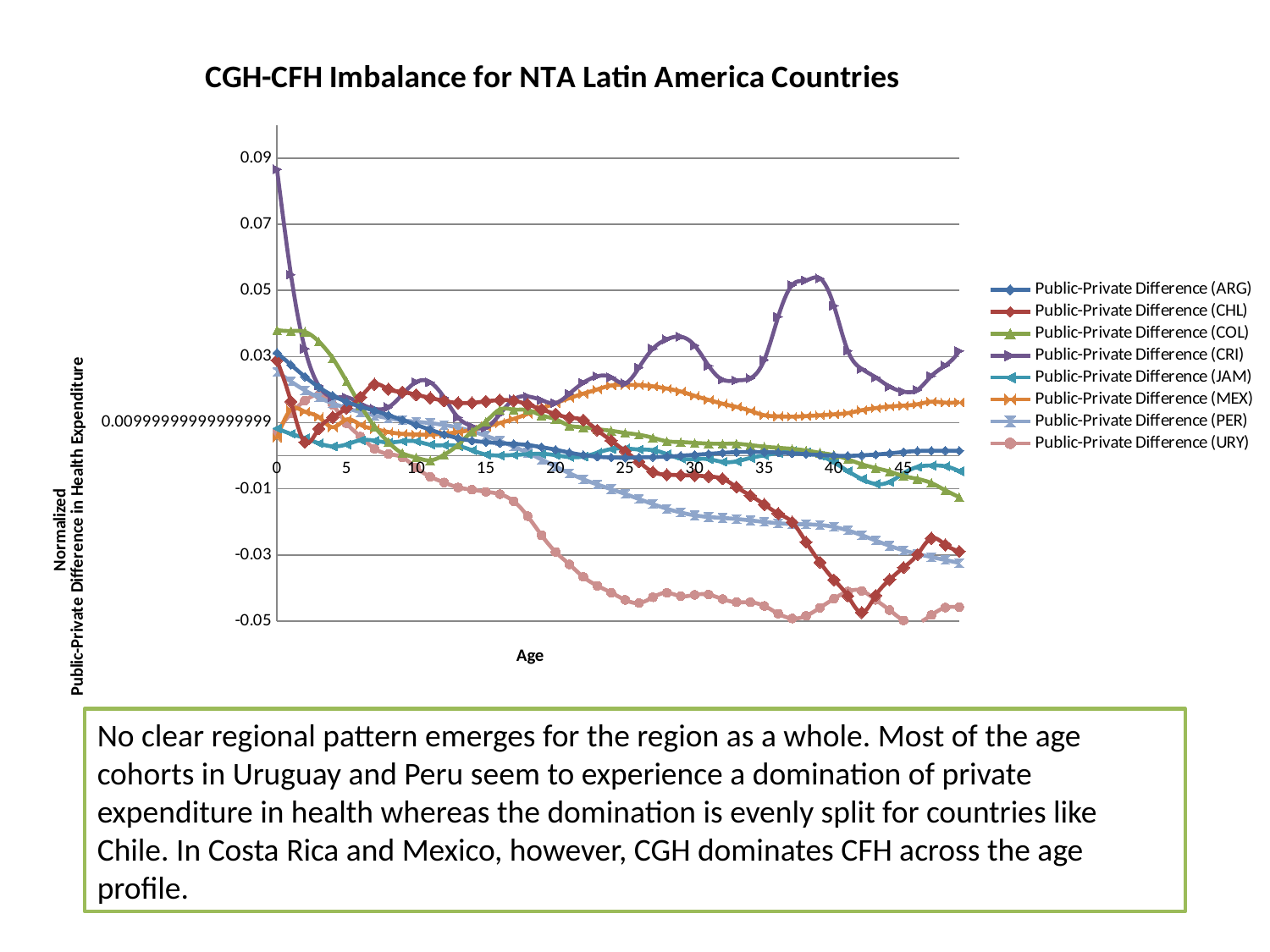
What is the label of the x axis? Age What kind of chart is shown on the slide? Line chart Is the value for Public-Private Difference (CRI) at age 0 greater or less than 0.07? greater What is the title of the chart? CGH-CFH Imbalance for NTA Latin America Countries How many series does the legend list? 8 Which series has the lowest value at age 45? Public-Private Difference (URY) Is the value for Public-Private Difference (URY) at age 25 greater or less than -0.03? less Does the Public-Private Difference (URY) series generally rise or fall from age 0 to age 45? Fall Is the value for Public-Private Difference (CRI) at age 38 greater or less than 0.03? greater Does the Public-Private Difference (PER) series generally rise or fall as age increases? Fall Which series has the highest value at age 0? Public-Private Difference (CRI) At age 40, which is larger: Public-Private Difference (CRI) or Public-Private Difference (URY)? Public-Private Difference (CRI)